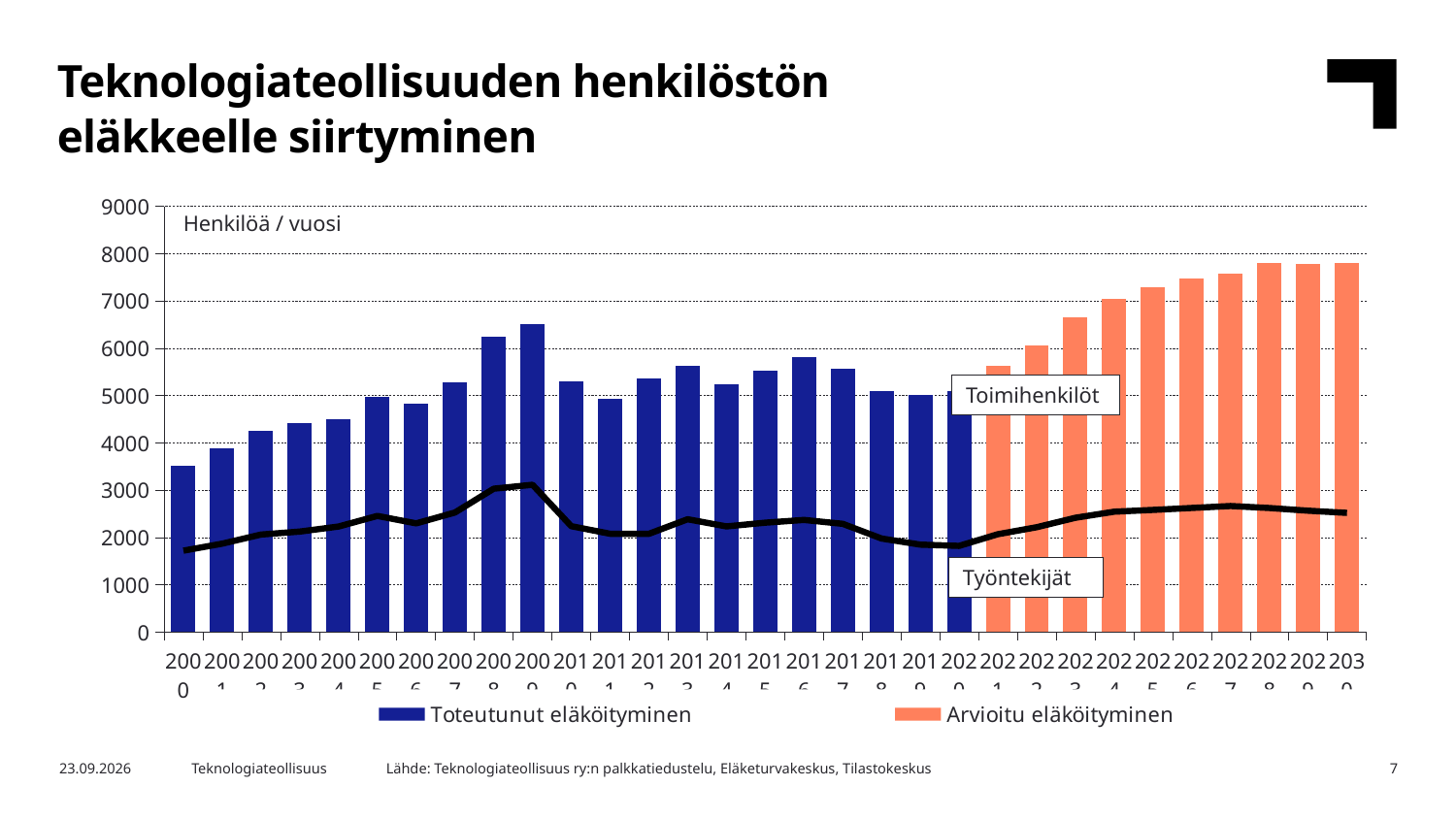
Which year has the lowest bar in the chart? 2000 How many years (bars) are plotted on the x axis? 31 Do the orange 'Arvioitu eläköityminen' bars rise or fall from 2021 to 2030? rise Is the bar for 2030 greater or less than 7000? greater Which bar is taller, 2009 or 2010? 2009 How many series does the legend list? 2 What kind of chart is shown on the slide? Bar chart (with a line) What are the two legend entries? Toteutunut eläköityminen and Arvioitu eläköityminen Is the bar for 2009 greater or less than 6000? greater Which year has the highest bar among the blue 'Toteutunut eläköityminen' bars? 2009 What is the title of the chart on the slide? Teknologiateollisuuden henkilöstön eläkkeelle siirtyminen Is the bar for 2000 greater or less than 4000? less